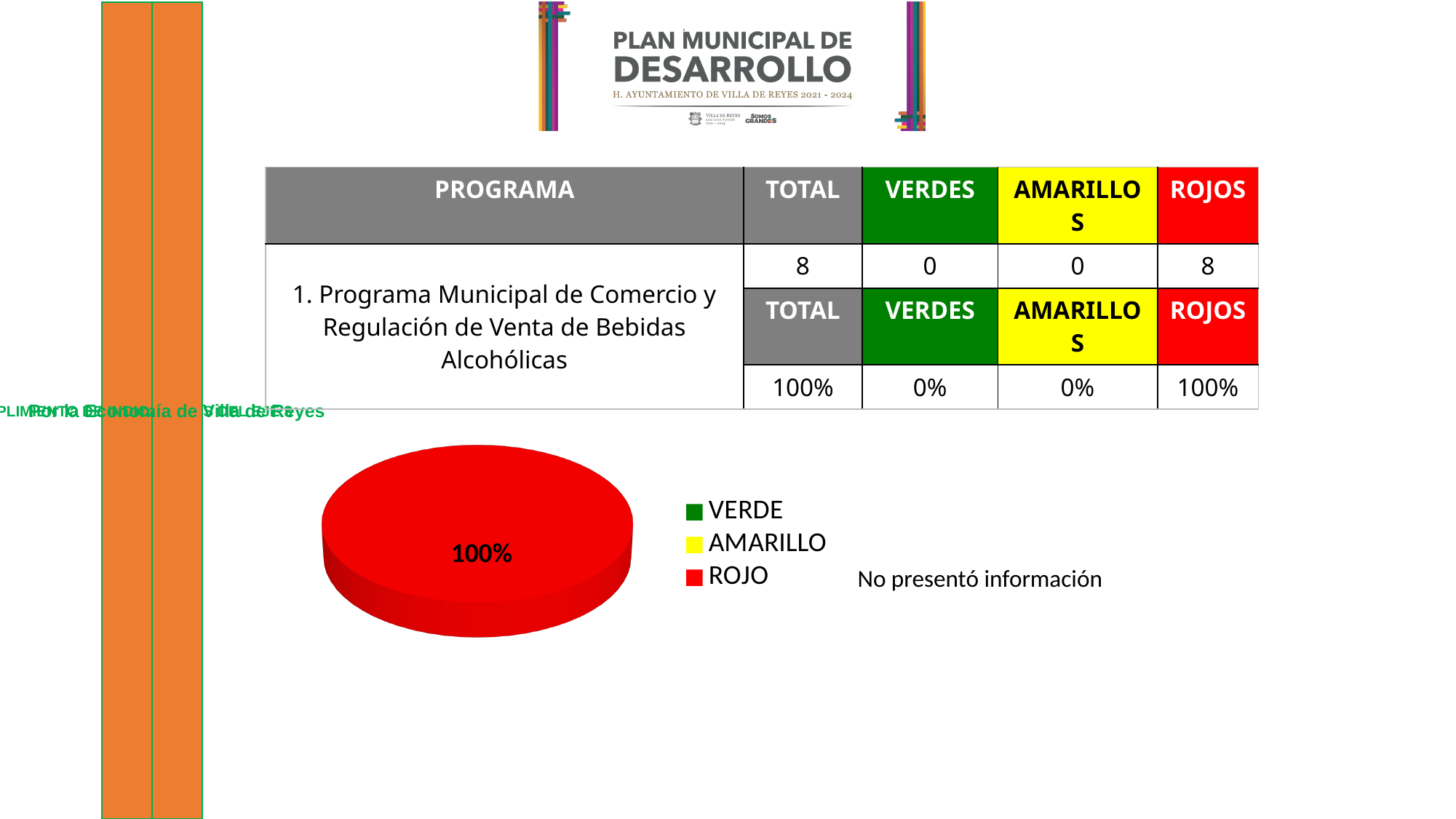
Is the share of the ROJO slice greater or less than 50%? greater What kind of chart is shown on the slide? pie chart Which legend entry is listed first in the pie chart's legend? VERDE What colour is the ROJO slice in the pie chart? red What share of the pie chart does the ROJO slice represent? 100% Which legend entry corresponds to the only visible slice of the pie chart? ROJO Which category has the largest slice in the pie chart? ROJO What data label is printed on the pie chart? 100% How many entries does the pie chart's legend list? 3